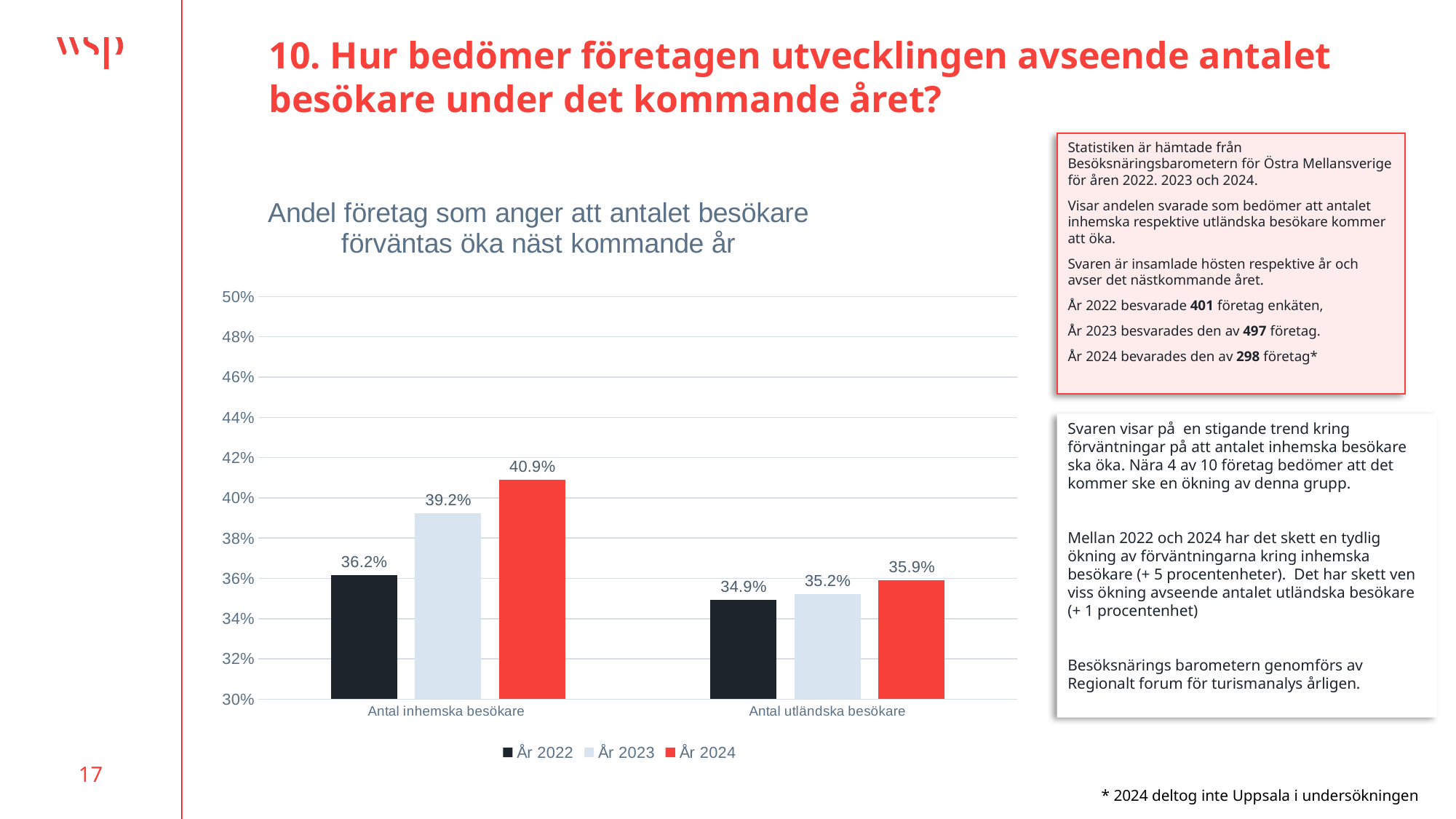
What is the difference between the År 2024 and År 2023 values for Antal utländska besökare? 0.7 percentage points What is the value for År 2022 in the Antal utländska besökare category? 34.9% What is the value for År 2024 in the Antal inhemska besökare category? 40.9% What is the difference between the År 2024 and År 2022 values for Antal inhemska besökare? 4.7 percentage points Which series has the lowest value in the Antal utländska besökare category? År 2022 Which is larger: the År 2023 value for Antal inhemska besökare or the År 2024 value for Antal utländska besökare? År 2023 value for Antal inhemska besökare What is the value for År 2023 in the Antal inhemska besökare category? 39.2% How many series does the legend list? 3 How many categories are shown on the x axis? 2 What kind of chart is shown on the slide? Bar chart Is the value for År 2024 in Antal inhemska besökare greater or less than 40%? greater Which series has the highest value in the Antal inhemska besökare category? År 2024